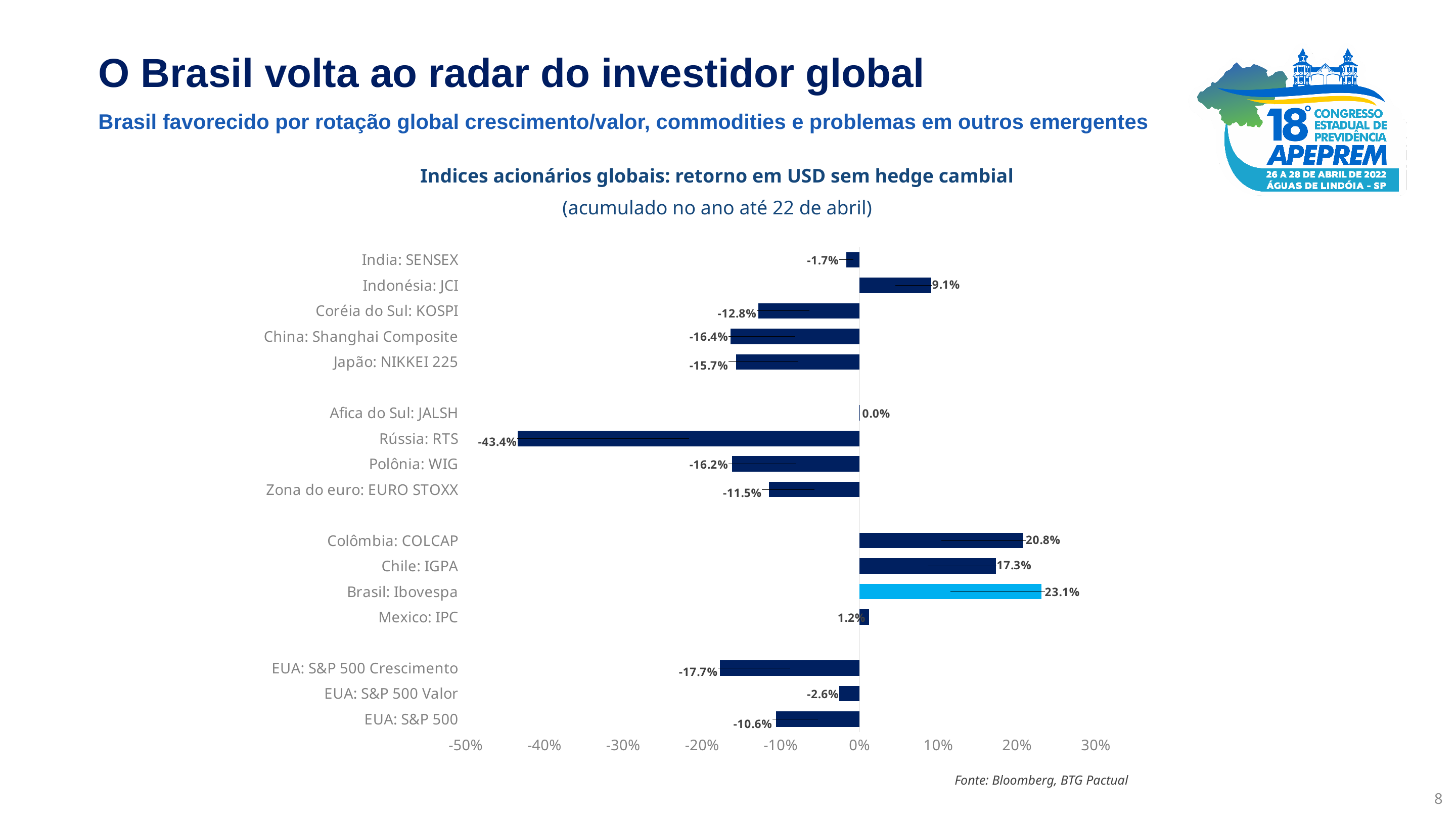
Which is larger, the value for Colômbia: COLCAP or Chile: IGPA? Colômbia: COLCAP What is the value for Afica do Sul: JALSH? 0.0% What is the value for Rússia: RTS? -43.4% What is the value for Brasil: Ibovespa? 23.1% Which bar is shown in a lighter blue colour than the others? Brasil: Ibovespa What is the difference between the values for Brasil: Ibovespa and Colômbia: COLCAP? 2.3 percentage points How many indices are shown in the chart? 16 Which index has the highest return? Brasil: Ibovespa What is the value for EUA: S&P 500 Crescimento? -17.7% What is the difference between the values for EUA: S&P 500 Valor and EUA: S&P 500 Crescimento? 15.1 percentage points What kind of chart is shown on the slide? Bar chart Which index has the lowest return? Rússia: RTS